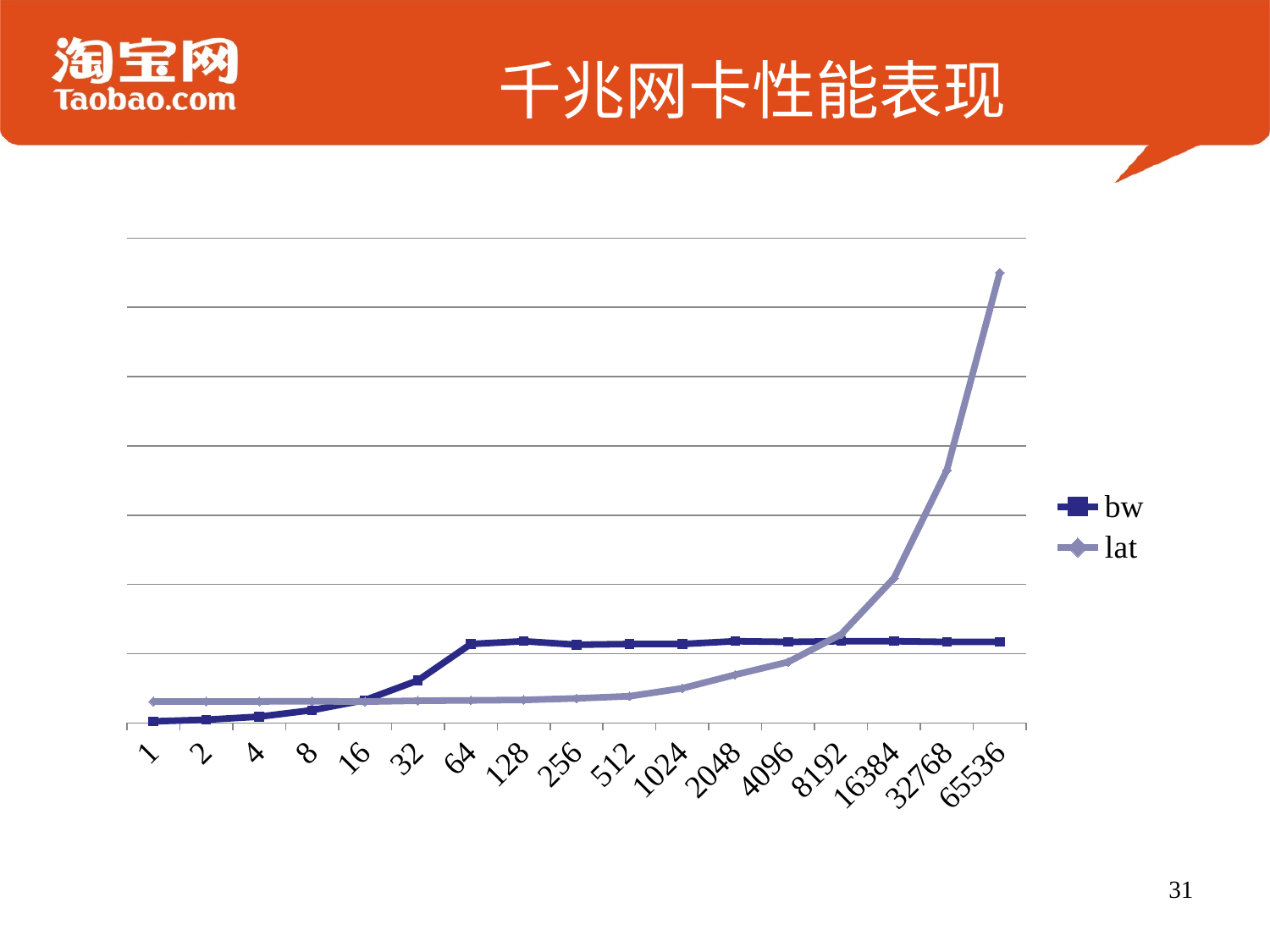
Does the lat series rise or fall overall from x = 1 to x = 65536? rise Does the bw series rise or fall from x = 1 to x = 64? rise At x = 64, which series has the larger value, bw or lat? bw How many series does the legend list? 2 At x = 65536, which series has the larger value, bw or lat? lat At x = 1, which series has the larger value, bw or lat? lat What kind of chart is shown on the slide? line chart How many categories are shown along the x axis? 17 At which x-axis category is the bw series at its lowest value? 1 At which x-axis category does the lat series reach its highest value? 65536 What is the title of the slide containing the chart? 千兆网卡性能表现 What are the two series named in the legend? bw and lat